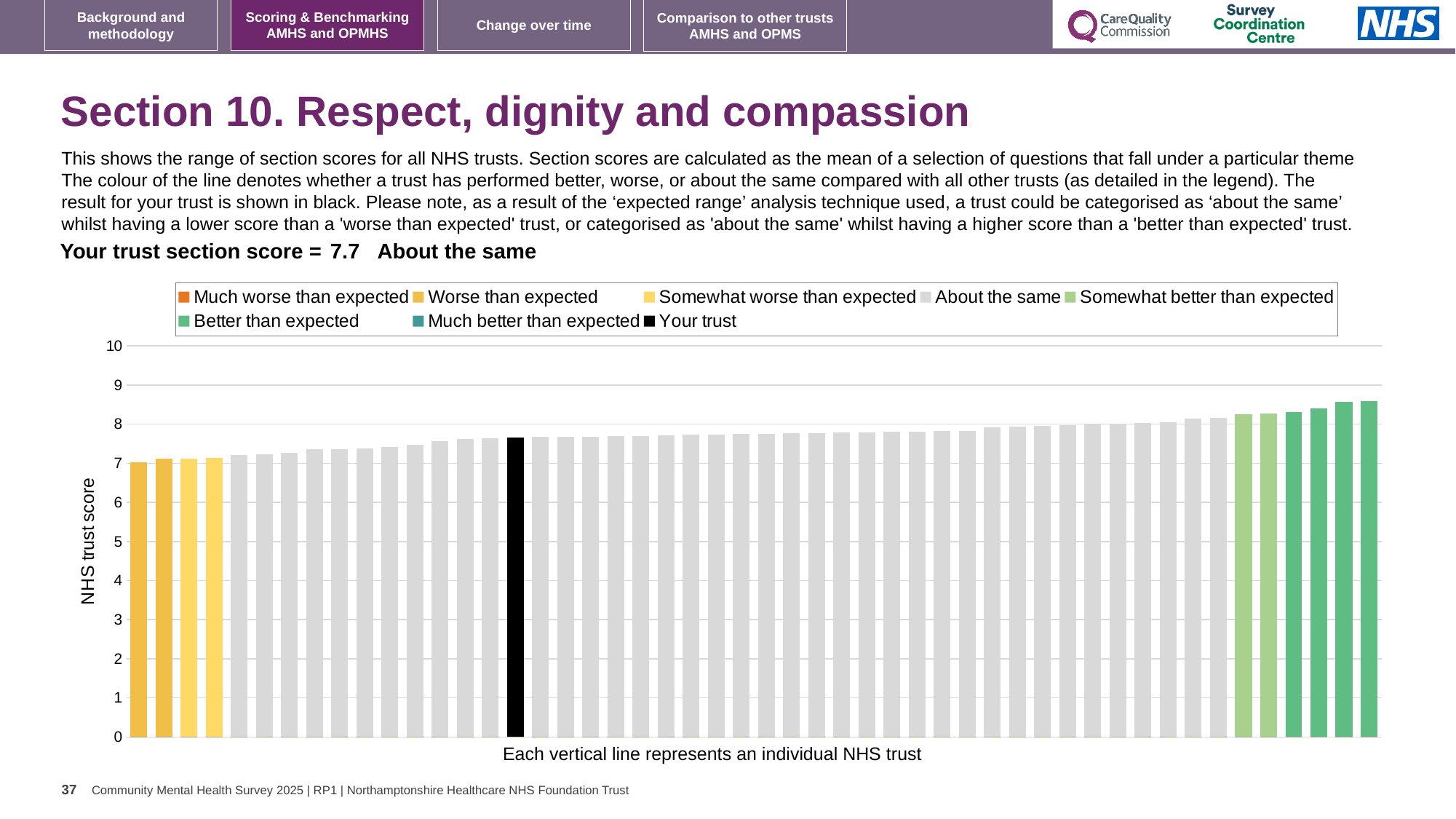
Is the black 'Your trust' bar higher or lower than the rightmost green bar? lower What does the text below the x axis say each vertical line represents? an individual NHS trust What is the label on the vertical axis of the chart? NHS trust score Is the value of the black 'Your trust' bar greater or less than 7? greater Do the bar values rise or fall moving from left to right along the x axis? rise Is the value of the leftmost bar on the chart greater or less than 6? greater Which category is your trust placed in for this section? About the same Is the value of the tallest bar on the chart greater or less than 8? greater How many entries does the chart legend list? 8 What is the section score for your trust shown on the slide? 7.7 What kind of chart is shown on the slide? bar chart